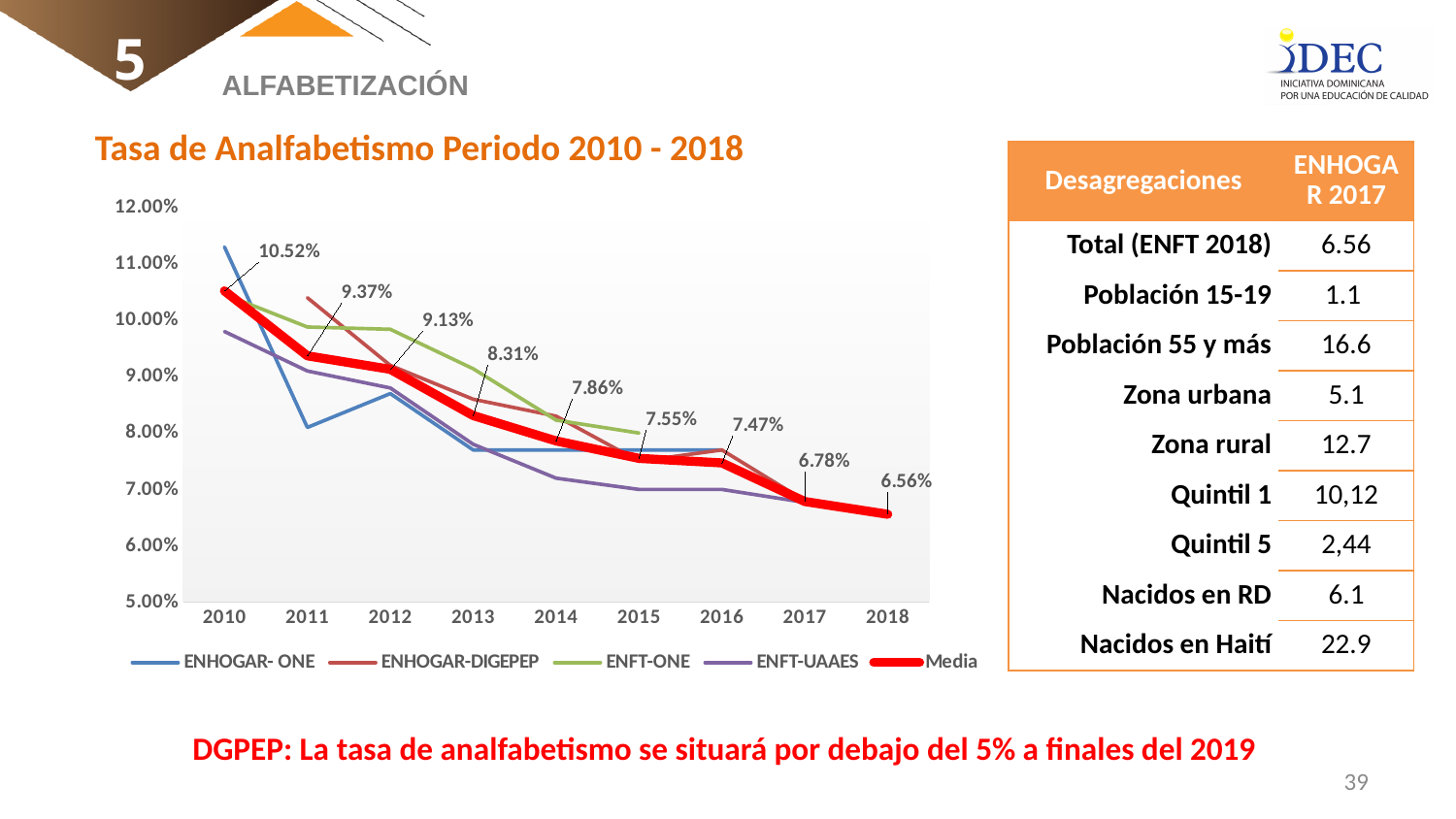
In which year is the Media value lowest? 2018 What is the Media value for 2010 in the chart? 10.52% In which year is the Media value highest? 2010 What is the Media value for 2016? 7.47% What is the difference between the Media value in 2010 and in 2018? 3.96 percentage points What is the Media value for 2018 in the chart? 6.56% What is the Media value for 2014? 7.86% Which is larger, the Media value for 2011 or for 2012? 2011 How many series does the chart legend list? 5 How many years are shown on the x axis of the chart? 9 What kind of chart is shown on the slide? Line chart Is the value for ENHOGAR- ONE in 2011 greater or less than 9.00%? less